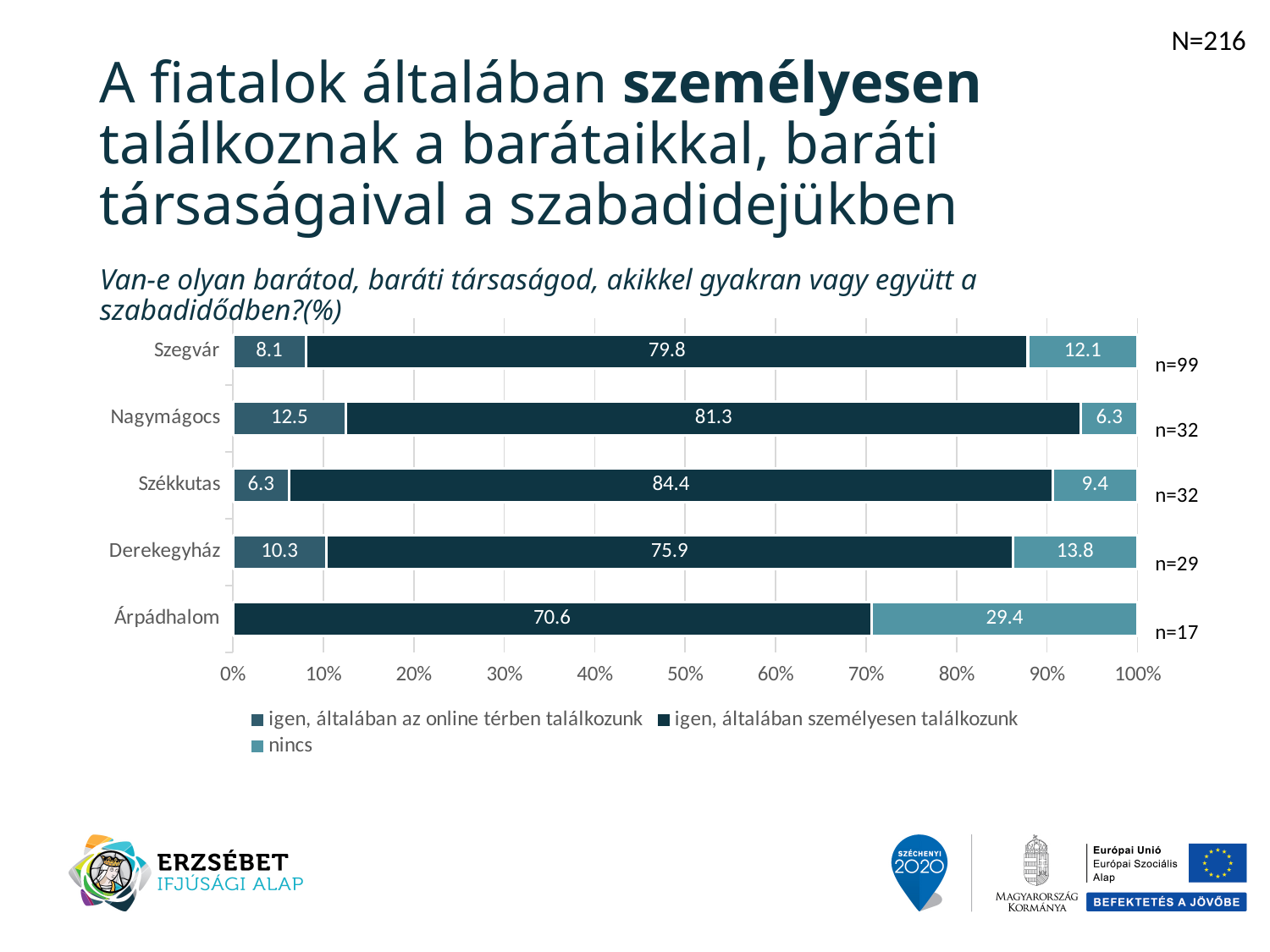
What is the value for 'nincs' for Árpádhalom? 29.4 How many series does the legend list? 3 What is the value for 'igen, általában személyesen találkozunk' for Székkutas? 84.4 What is the difference between the 'nincs' values for Derekegyház and Szegvár? 1.7 Which settlement has the highest value for 'igen, általában személyesen találkozunk'? Székkutas Is the 'igen, általában személyesen találkozunk' value for Árpádhalom greater or less than 80%? less Which settlement has the lowest value for 'igen, általában személyesen találkozunk'? Árpádhalom Which is larger: the 'igen, általában az online térben találkozunk' value for Szegvár or for Derekegyház? Derekegyház What is the value for 'igen, általában az online térben találkozunk' for Nagymágocs? 12.5 What sample size (n) is shown next to the Szegvár bar? n=99 How many settlements (categories) are shown on the chart? 5 What kind of chart is shown on the slide? Stacked bar chart